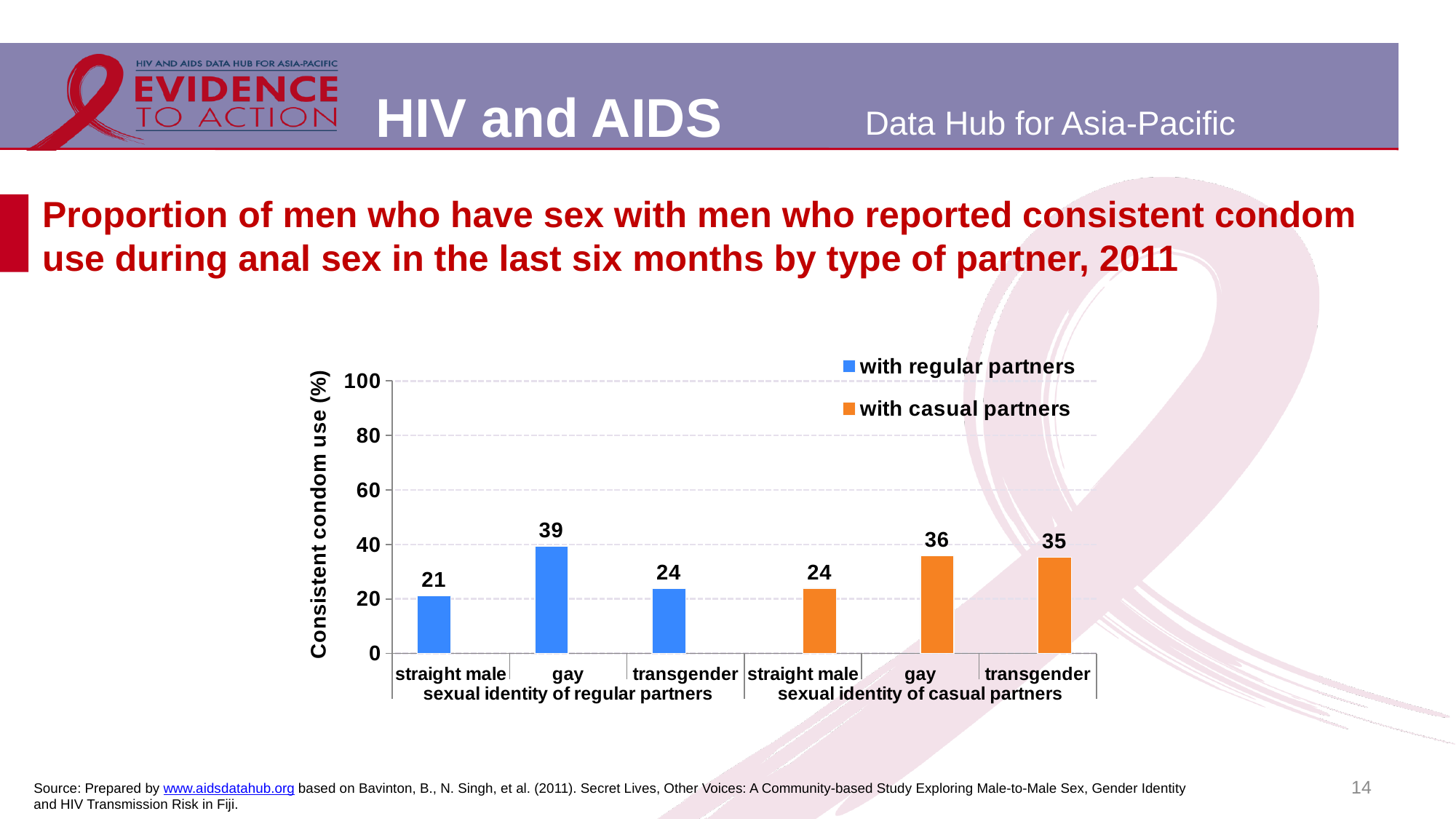
What is the difference between the value for gay men with regular partners and gay men with casual partners? 3 What is the consistent condom use value for gay men with regular partners? 39 What is the difference between the value for transgender with casual partners and transgender with regular partners? 11 What is the value for transgender with casual partners? 35 Which is larger: the value for straight male with regular partners or straight male with casual partners? straight male with casual partners Which category has the highest consistent condom use value? gay (with regular partners) What is the consistent condom use value for straight male with casual partners? 24 How many bars are plotted in the chart? 6 Which category has the lowest consistent condom use value? straight male (with regular partners) What kind of chart is shown on the slide? bar chart How many series does the legend list? 2 Is the value for gay men with casual partners greater or less than 40? less